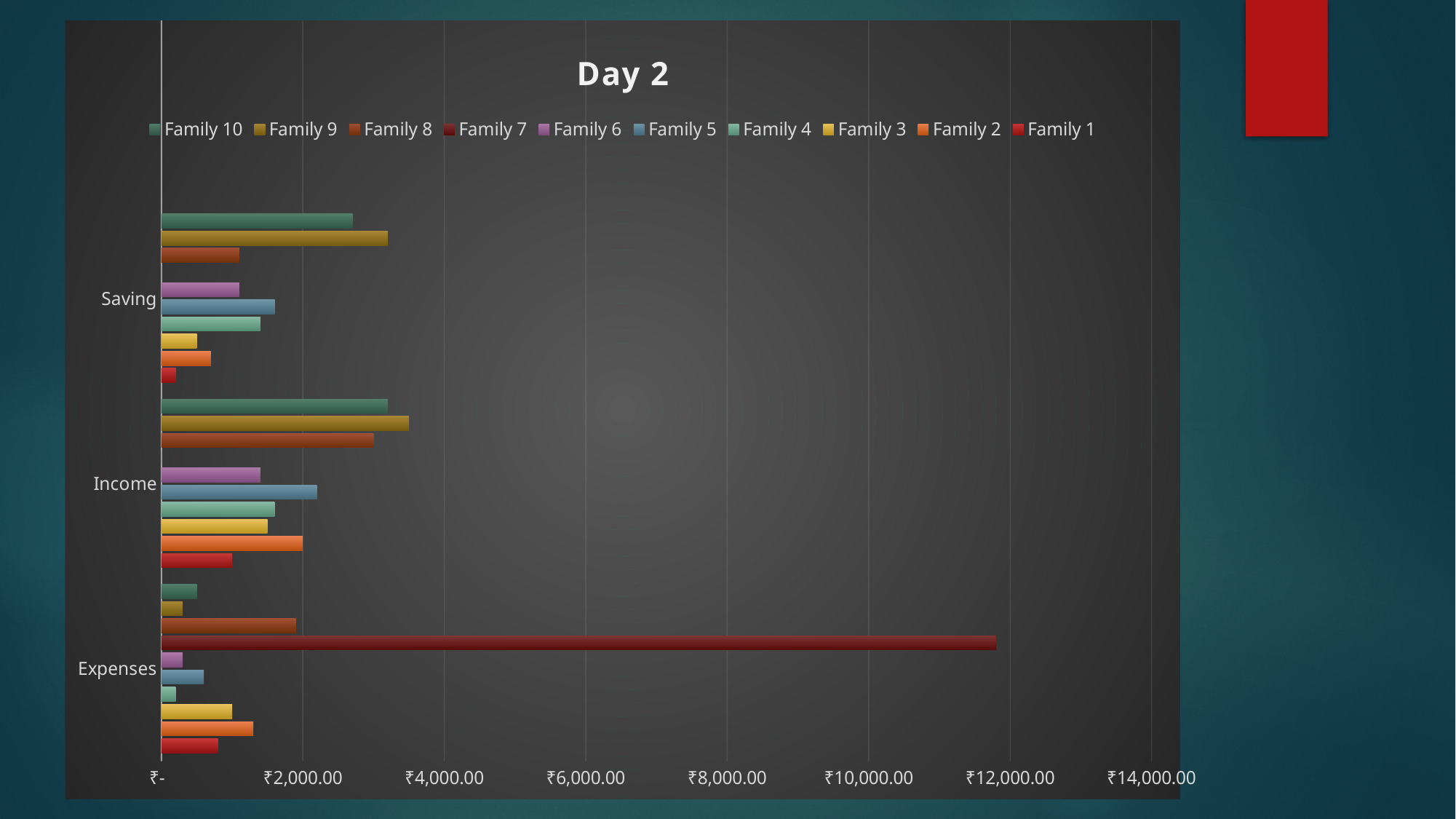
Which is larger: the Expenses value for Family 7 or the Expenses value for Family 8? Family 7 Which family has the highest Saving value? Family 9 Which family has the highest Expenses value? Family 7 Is the Expenses value for Family 7 greater or less than ₹10,000.00? greater Which is larger: the Income value for Family 2 or the Income value for Family 1? Family 2 Is the Saving value for Family 1 greater or less than ₹2,000.00? less How many categories are shown on the vertical axis? 3 How many series does the legend list? 10 Is the Income value for Family 9 greater or less than ₹2,000.00? greater What is the title of the chart? Day 2 What kind of chart is shown on the slide? Bar chart What is the highest value shown on the horizontal axis? ₹14,000.00